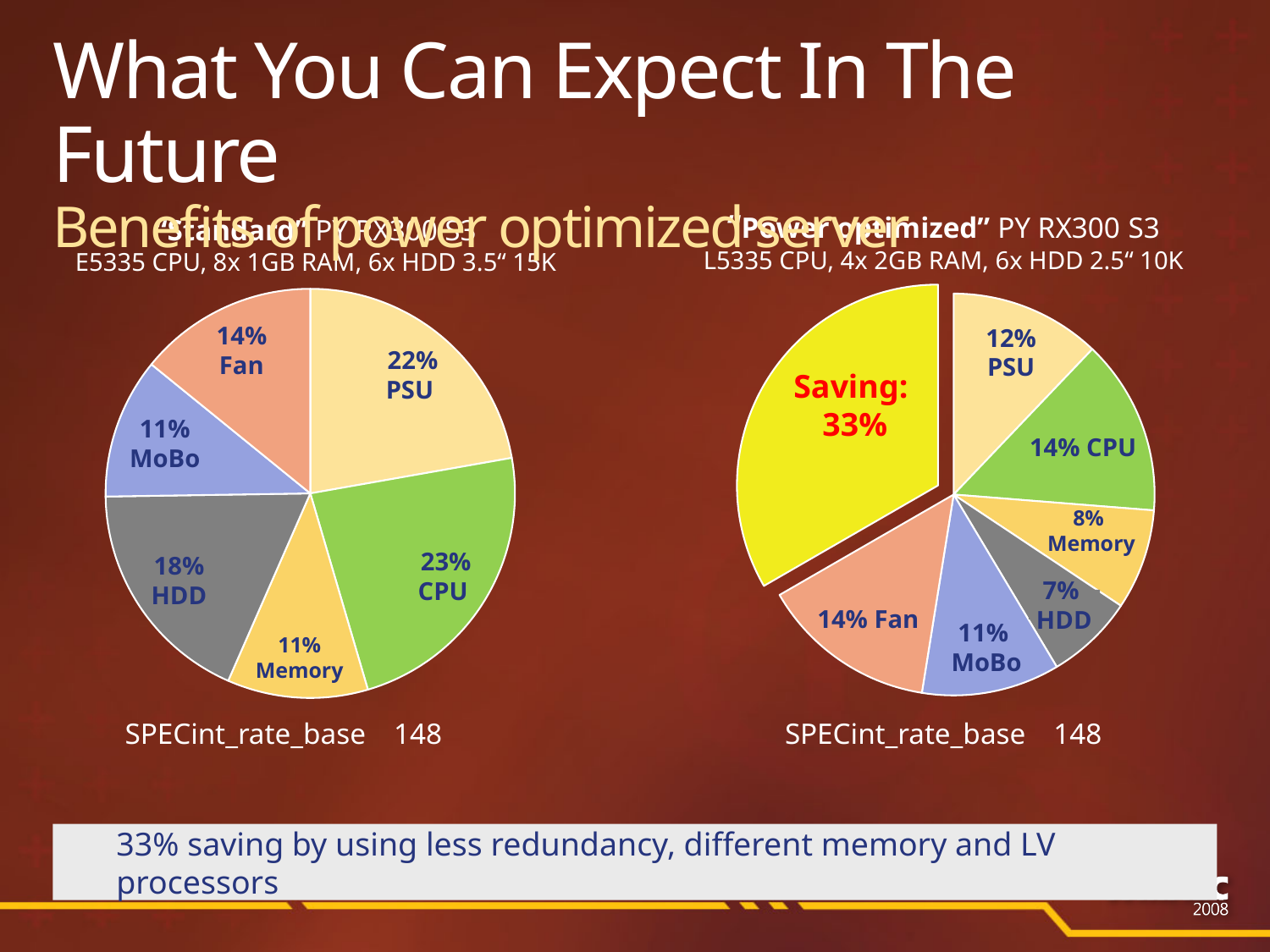
In the right pie chart ("Power optimized" PY RX300 S3), how many slices are there including the Saving slice? 7 In the left pie chart ("Standard" PY RX300 S3), what share does the PSU slice have? 22% What is the difference between the HDD share in the left pie chart (18%) and the HDD share in the right pie chart (7%)? 11% In the right pie chart ("Power optimized" PY RX300 S3), what share is labelled as Saving? 33% In the right pie chart ("Power optimized" PY RX300 S3), what share does the Memory slice have? 8% In the left pie chart ("Standard" PY RX300 S3), which component has the largest share? CPU In the left pie chart ("Standard" PY RX300 S3), how many slices are there? 6 What type of chart is used on the left side of the slide? Pie chart What SPECint_rate_base value is shown below each pie chart? 148 Which is larger: the CPU share in the left pie chart or the CPU share in the right pie chart? Left pie chart (23%) In the right pie chart ("Power optimized" PY RX300 S3), which component has the smallest share? HDD In the left pie chart ("Standard" PY RX300 S3), what share does the HDD slice have? 18%